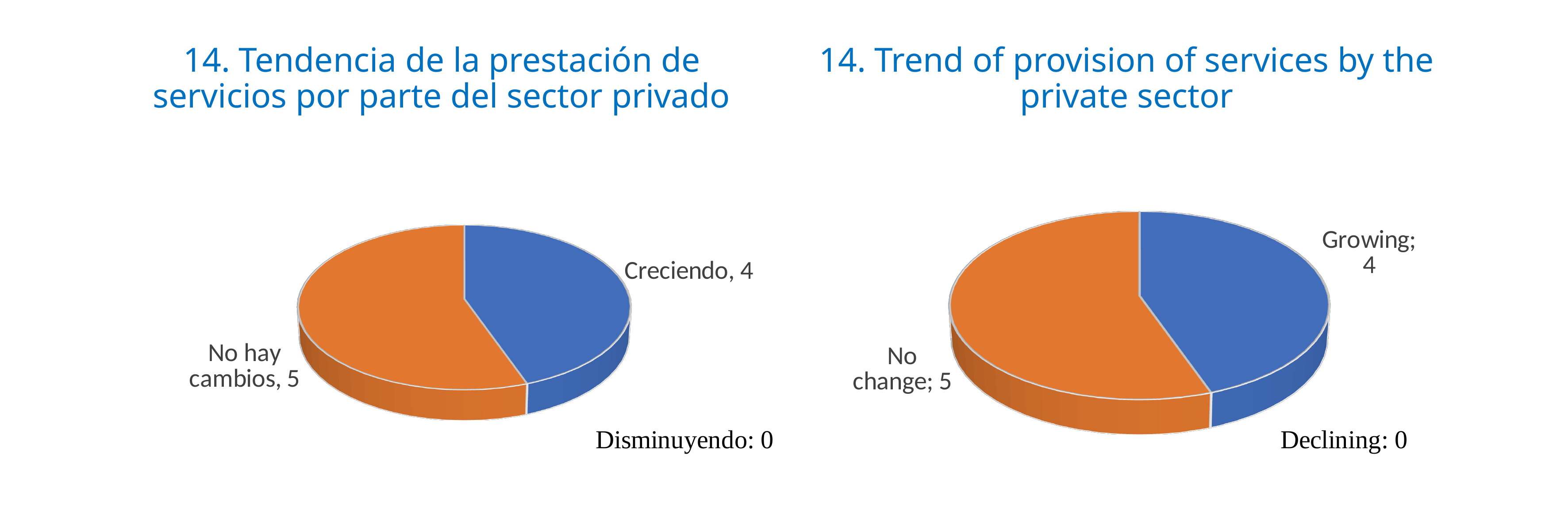
In the right chart (14. Trend of provision of services by the private sector), what value is given for Declining? 0 In the right chart (14. Trend of provision of services by the private sector), which category has the largest slice? No change In the left chart (14. Tendencia de la prestación de servicios por parte del sector privado), what is the value for Creciendo? 4 In the right chart (14. Trend of provision of services by the private sector), what is the value for Growing? 4 In the left chart (14. Tendencia de la prestación de servicios por parte del sector privado), what value is given for Disminuyendo? 0 In the left chart (14. Tendencia de la prestación de servicios por parte del sector privado), which is larger, Creciendo or No hay cambios? No hay cambios In the right chart (14. Trend of provision of services by the private sector), what is the difference between the values for No change and Growing? 1 What kind of chart is the right chart (14. Trend of provision of services by the private sector)? Pie chart In the left chart (14. Tendencia de la prestación de servicios por parte del sector privado), which category has the largest slice? No hay cambios In the left chart (14. Tendencia de la prestación de servicios por parte del sector privado), what is the value for No hay cambios? 5 In the right chart (14. Trend of provision of services by the private sector), what is the value for No change? 5 In the right chart (14. Trend of provision of services by the private sector), what colour is the Growing slice? Blue